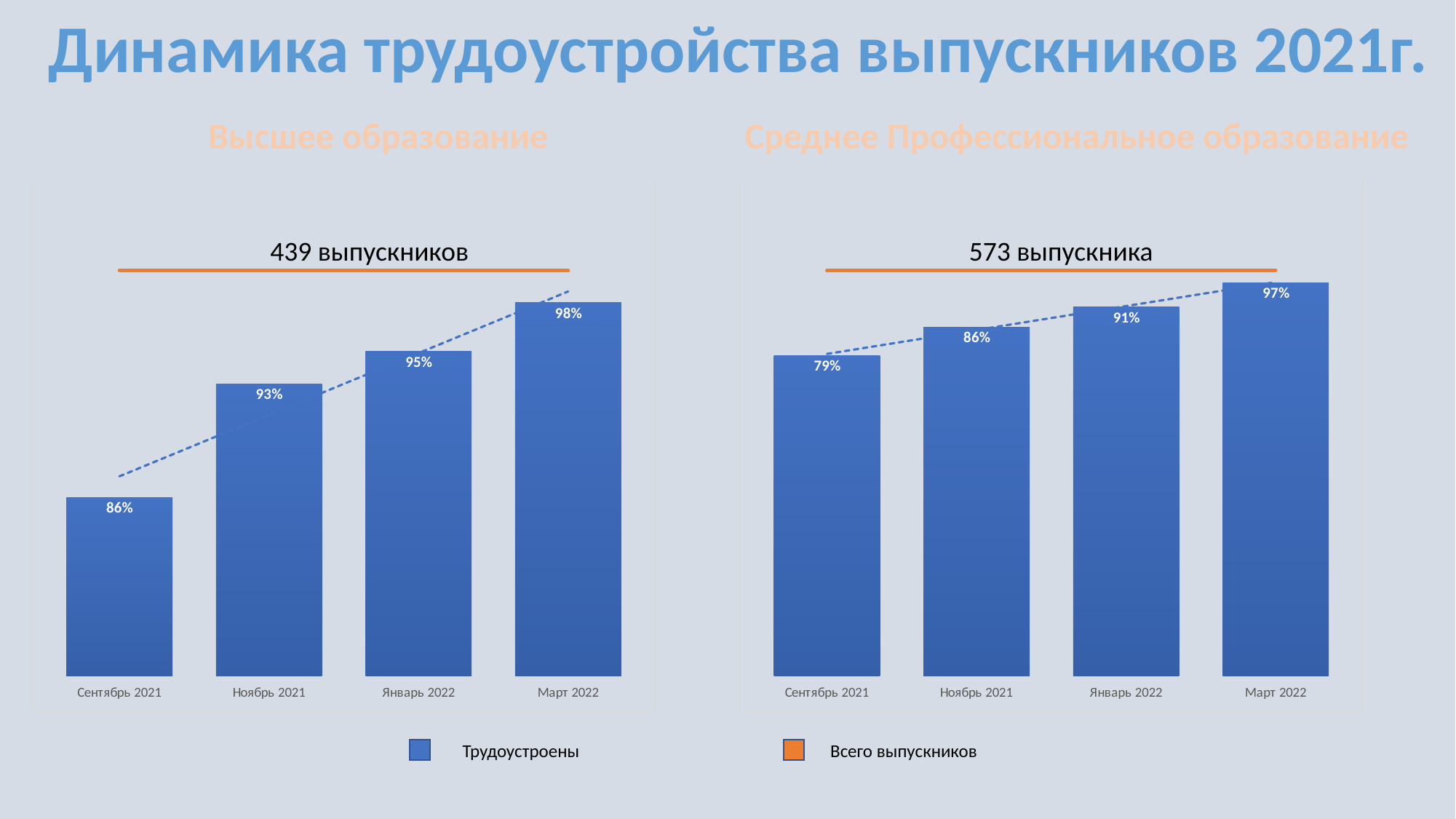
Which is larger: the Ноябрь 2021 value in the left chart (Высшее образование) or the Ноябрь 2021 value in the right chart (Среднее Профессиональное образование)? Left chart (Высшее образование), 93% In the right chart (Среднее Профессиональное образование), which category has the highest value? Март 2022 In the left chart (Высшее образование), what is the value for Сентябрь 2021? 86% What total number of graduates is shown above the right chart (Среднее Профессиональное образование)? 573 выпускника In the right chart (Среднее Профессиональное образование), what is the difference between the values for Ноябрь 2021 and Сентябрь 2021? 7% In the left chart (Высшее образование), what is the value for Март 2022? 98% In the left chart (Высшее образование), what is the difference between the values for Март 2022 and Сентябрь 2021? 12% How many categories are shown on the x axis of the left chart (Высшее образование)? 4 In the left chart (Высшее образование), which category has the lowest value? Сентябрь 2021 In the right chart (Среднее Профессиональное образование), what is the value for Сентябрь 2021? 79% In the right chart (Среднее Профессиональное образование), do the values rise or fall from Сентябрь 2021 to Март 2022? Rise In the right chart (Среднее Профессиональное образование), what is the value for Январь 2022? 91%